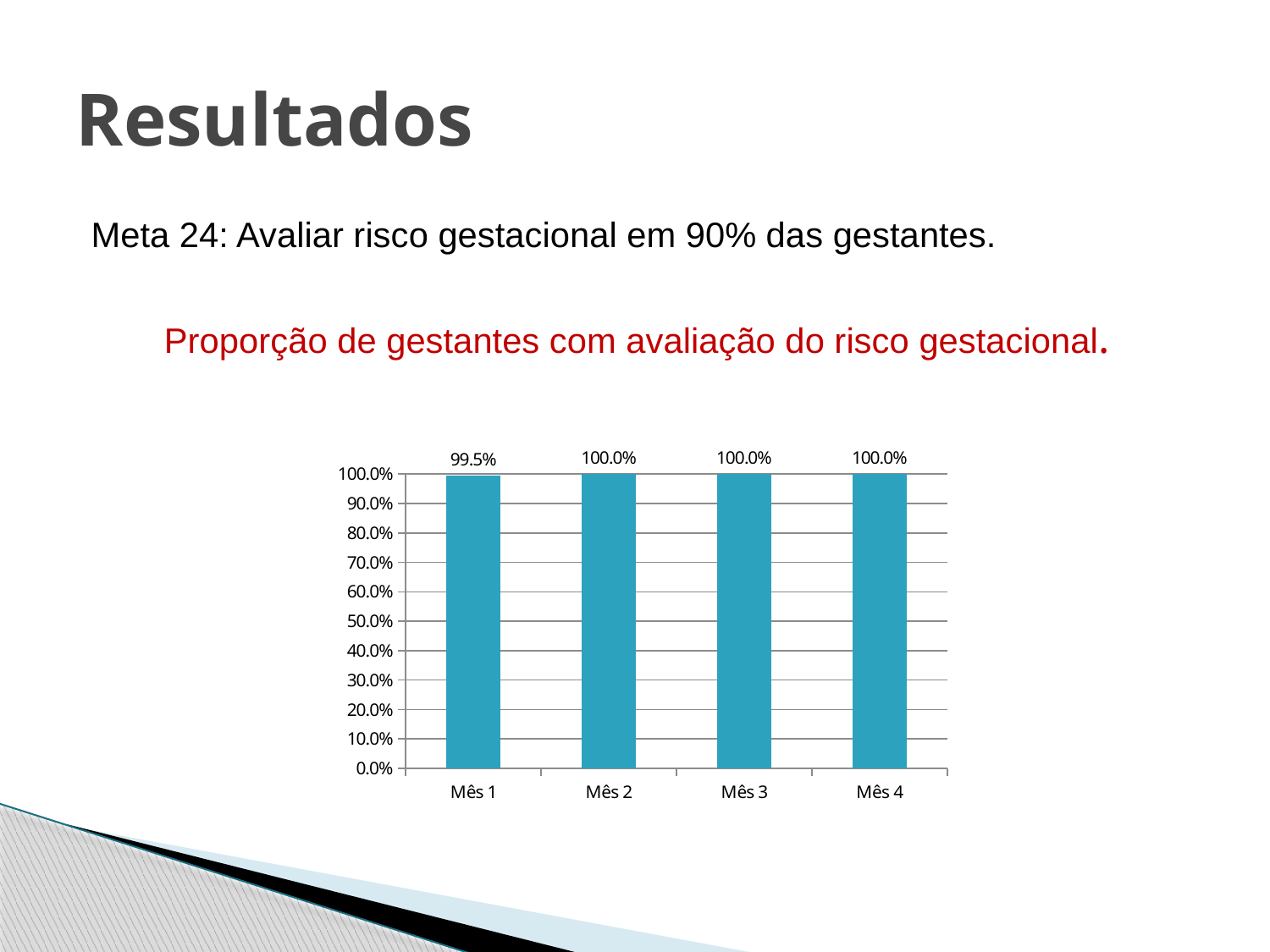
What is the title of the chart shown in red above it? Proporção de gestantes com avaliação do risco gestacional. What is the value for Mês 1? 99.5% What is the highest value shown on the y axis? 100.0% Which is larger, the value for Mês 1 or the value for Mês 2? Mês 2 What is the difference between the values for Mês 2 and Mês 1? 0.5% How many months are shown on the x axis? 4 What is the value for Mês 3? 100.0% Is the value for Mês 1 greater or less than 90.0%? greater What kind of chart is shown on the slide? bar chart Do the values rise or fall from Mês 1 to Mês 2? rise What is the value for Mês 4? 100.0% Which month has the lowest value? Mês 1